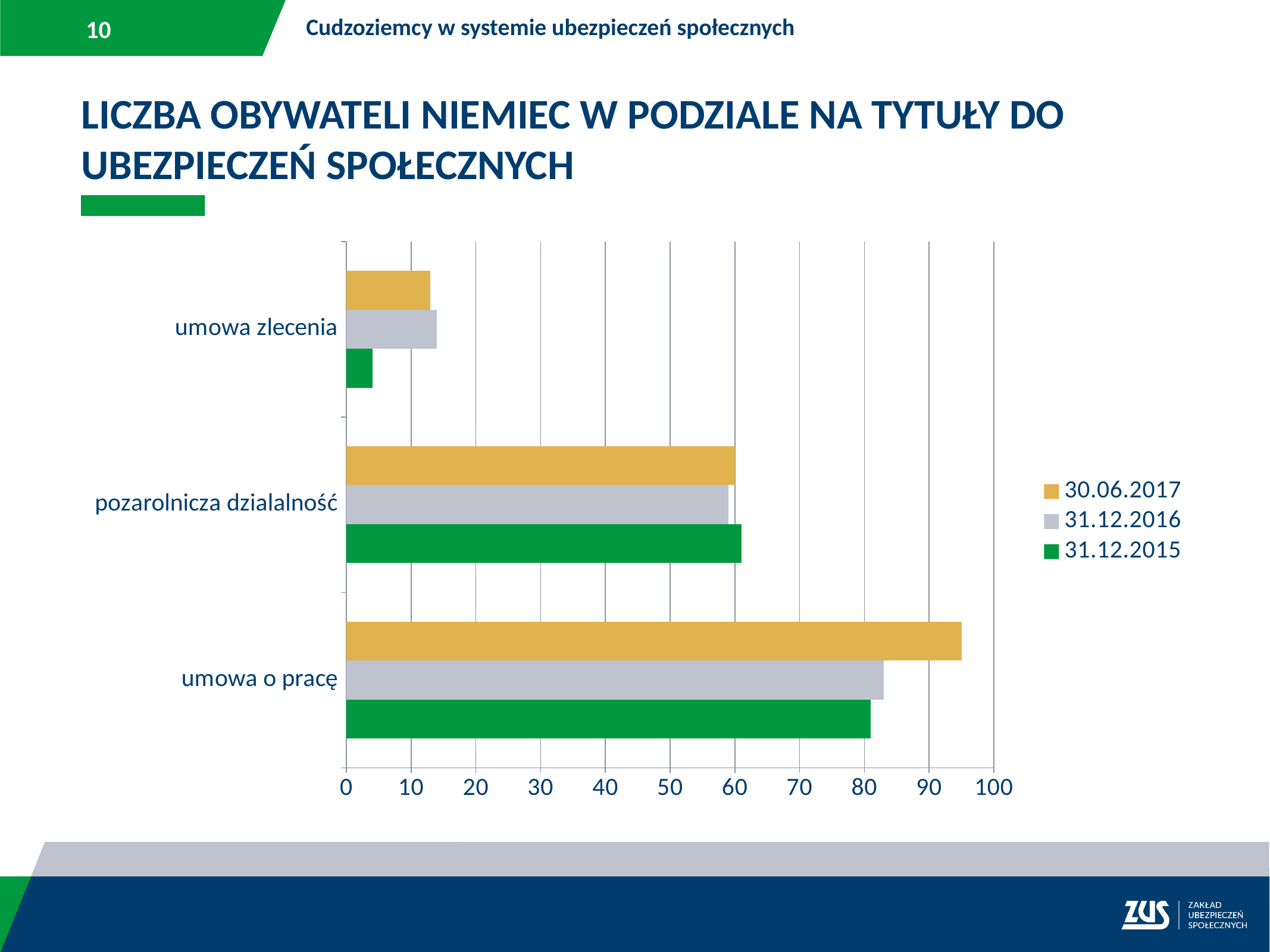
Which category has the lowest value for the 31.12.2015 series? umowa zlecenia How many categories are shown on the chart? 3 Is the value for umowa o pracę in the 30.06.2017 series greater or less than 90? greater How many series does the legend list? 3 For umowa o pracę, which series has the larger value: 30.06.2017 or 31.12.2016? 30.06.2017 For umowa zlecenia, which series has the larger value: 31.12.2015 or 30.06.2017? 30.06.2017 Is the value for umowa zlecenia in the 31.12.2015 series greater or less than 10? less What kind of chart is shown on the slide? bar chart Is the value for umowa o pracę in the 31.12.2015 series greater or less than 90? less Which category has the highest value for the 30.06.2017 series? umowa o pracę Which colour represents the 31.12.2015 series in the legend? green